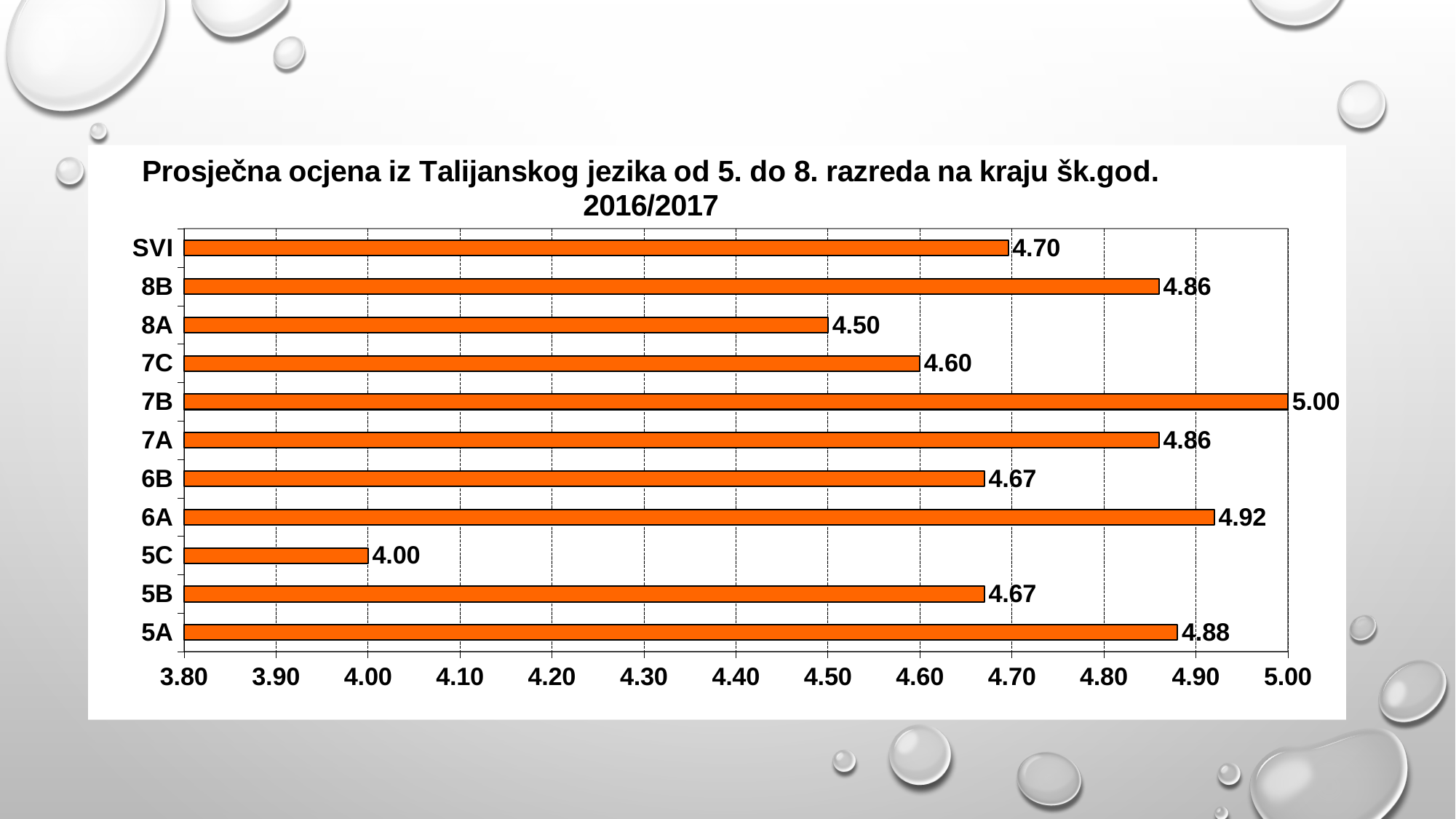
What is the value for 7B? 5.00 What is the value for SVI? 4.70 Which category has the lowest value? 5C What is the difference between the values for 5A and 8A? 0.38 What is the value for 5C? 4.00 Which is larger, the value for 6A or the value for 8B? 6A What is the difference between the values for 7B and 5C? 1.00 What is the value for 6A? 4.92 What kind of chart is this? Bar chart How many categories are shown on the chart? 11 Which category has the highest value? 7B What colour are the bars in the chart? Orange